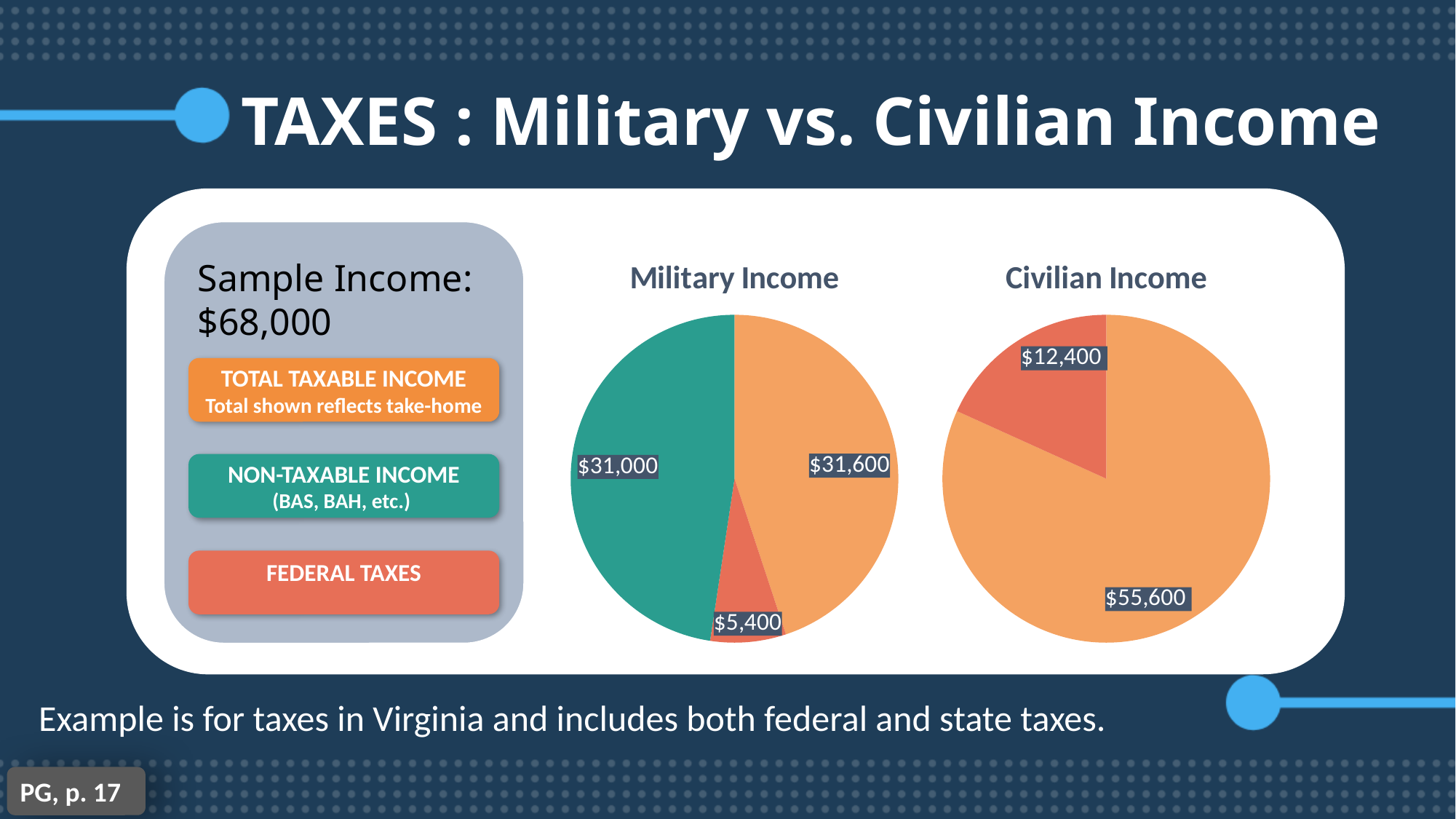
What is the difference between the Federal Taxes values in the Civilian Income chart and the Military Income chart? $7,000 In the Military Income chart, which slice is the smallest? Federal Taxes In the Civilian Income chart, what is the value of the Federal Taxes slice? $12,400 In the Military Income chart, what is the value of the Total Taxable Income slice? $31,600 In the Military Income chart, what is the difference between Total Taxable Income and Non-Taxable Income? $600 Which is larger: Federal Taxes in the Military Income chart or Federal Taxes in the Civilian Income chart? Civilian Income How many slices does the Civilian Income chart have? 2 In the Military Income chart, what is the value of the Federal Taxes slice? $5,400 In the Civilian Income chart, which slice is the largest? Total Taxable Income In the Military Income chart, what is the value of the Non-Taxable Income slice? $31,000 In the Civilian Income chart, what is the value of the Total Taxable Income slice? $55,600 What type of chart is the Military Income chart? Pie chart